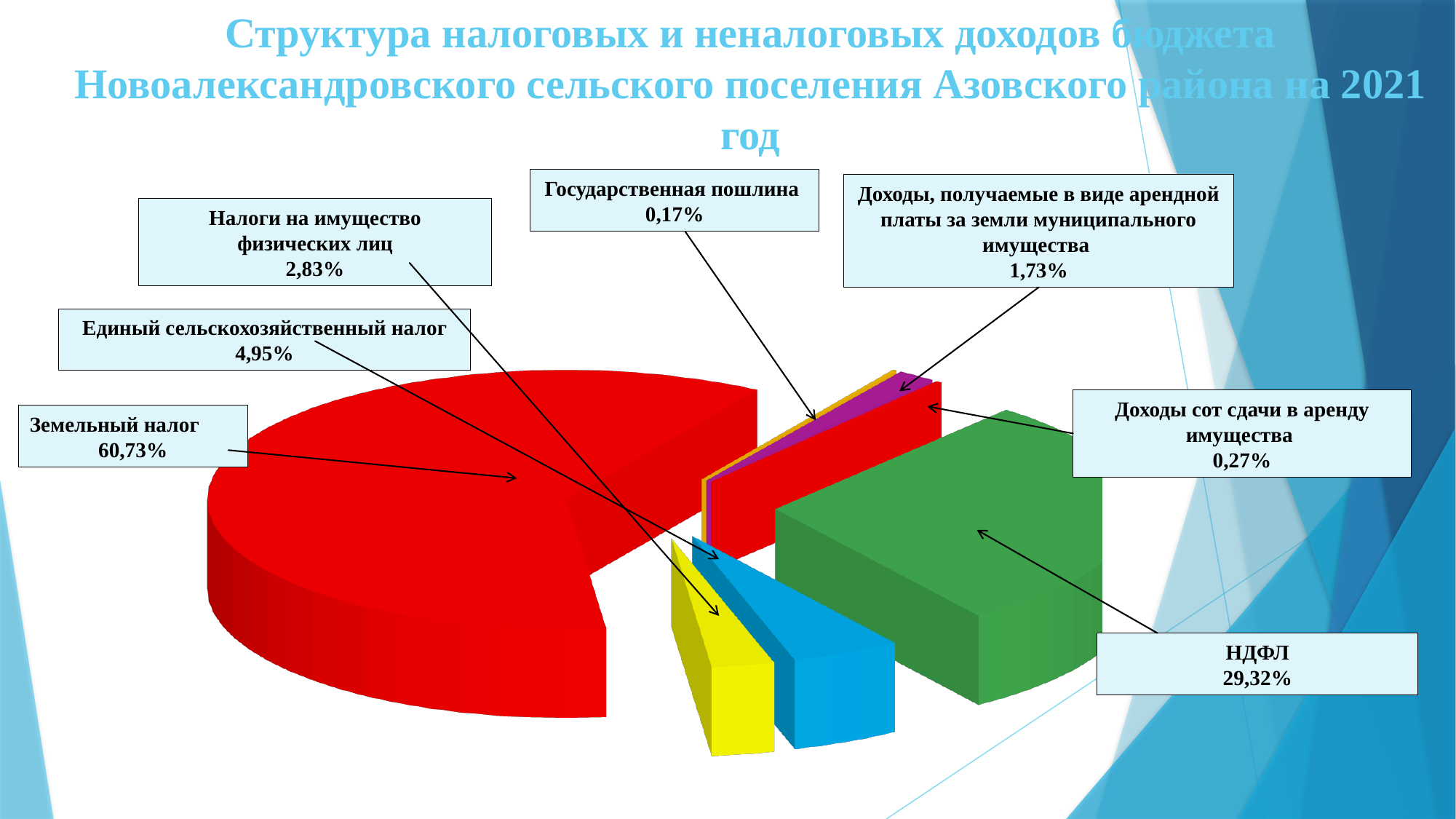
What is the value shown for НДФЛ? 29,32% What kind of chart is shown on the slide? Pie chart What is the value shown for Доходы, получаемые в виде арендной платы за земли муниципального имущества? 1,73% What is the difference between the shares of Земельный налог and НДФЛ? 31,41% Which category has the smallest share of the pie? Государственная пошлина What colour is the slice for НДФЛ? Green Which is larger: Налоги на имущество физических лиц or Единый сельскохозяйственный налог? Единый сельскохозяйственный налог What share of the budget revenue does Земельный налог account for? 60,73% What is the value shown for Единый сельскохозяйственный налог? 4,95% Which category has the largest share of the pie? Земельный налог How many categories are shown in the pie chart? 7 What is the value shown for Государственная пошлина? 0,17%